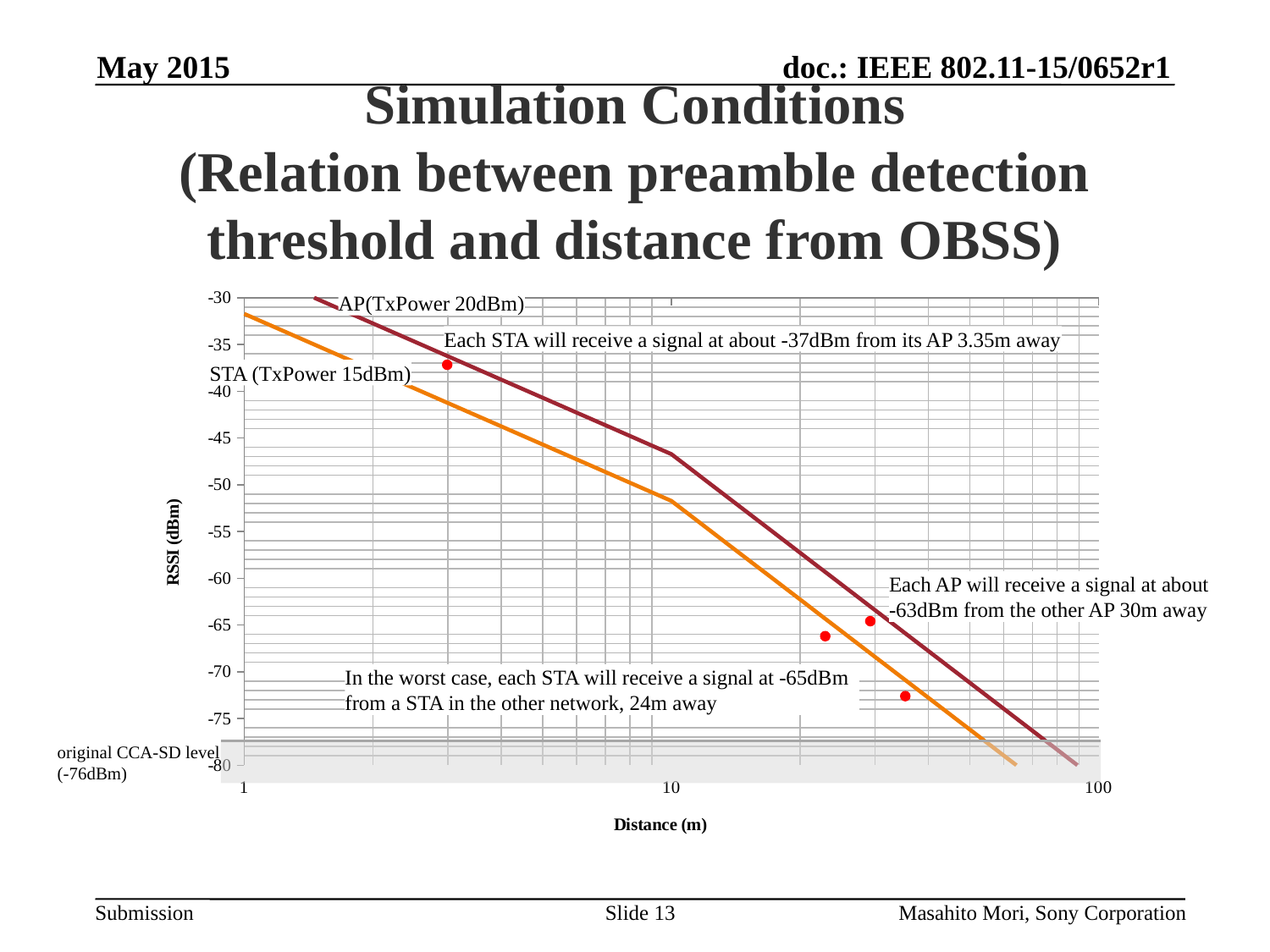
What is the label of the x axis? Distance (m) Is the RSSI of the AP line at 10 m greater or less than -50? greater At 10 m, which line has the higher RSSI, AP or STA? AP What is the original CCA-SD level marked on the chart? -76dBm What transmit power is given for the STA line? 15dBm Is the RSSI of the STA line at 10 m greater or less than -50? less How many lines are plotted on the chart? 2 Does RSSI rise or fall as distance increases along the x axis? fall What transmit power is given for the AP line? 20dBm What kind of chart is shown on the slide? line chart What is the label of the y axis? RSSI (dBm) How many red dot markers are plotted on the chart? 4